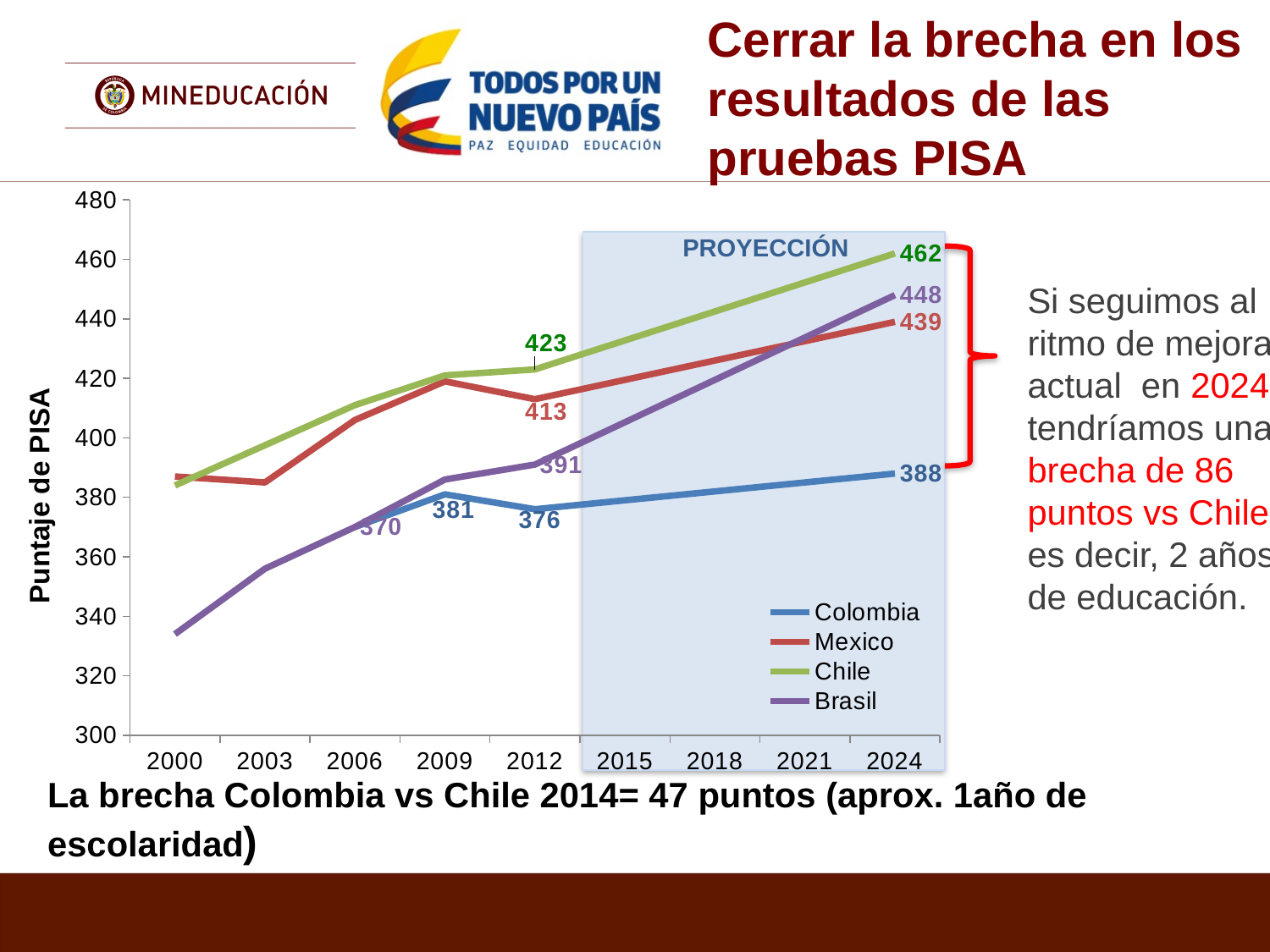
Which series has the lowest projected value in 2024? Colombia What is the PISA score for Colombia in 2009? 381 What is the PISA score for Mexico in 2012? 413 Is the value for Brasil in 2000 greater or less than 340? less What is the projected PISA score for Colombia in 2024? 388 What is the projected PISA score for Chile in 2024? 462 What type of chart is shown on the slide? line chart What is the difference between the projected 2024 scores of Chile and Colombia? 74 How many series does the chart legend list? 4 What is the PISA score for Brasil in 2012? 391 Is the 2012 score for Chile larger than the 2012 score for Mexico? Yes Which series has the highest projected value in 2024? Chile